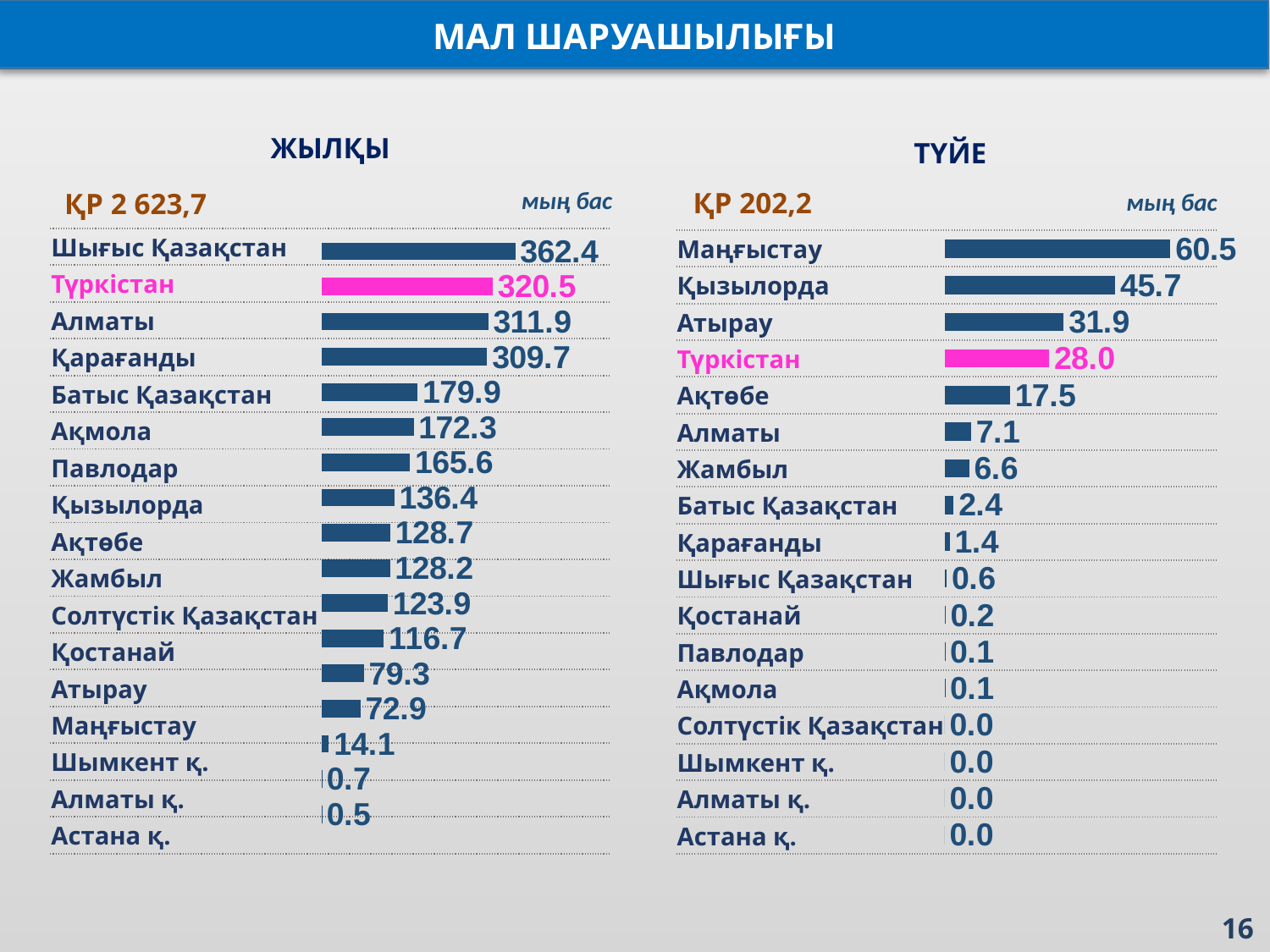
In the ЖЫЛҚЫ chart, what is the difference between Шығыс Қазақстан and Түркістан? 41.9 In the ЖЫЛҚЫ chart, what is the value for Түркістан? 320.5 In the ТҮЙЕ chart, what is the value for Маңғыстау? 60.5 In the ЖЫЛҚЫ chart, which category has the lowest value? Астана қ. What type of chart is the ТҮЙЕ chart? Bar chart How many categories are shown in the ЖЫЛҚЫ chart? 17 In the ЖЫЛҚЫ chart, which category's bar is highlighted in pink? Түркістан In the ТҮЙЕ chart, what is the difference between Қызылорда and Атырау? 13.8 In the ТҮЙЕ chart, which region has the highest value? Маңғыстау In the ЖЫЛҚЫ chart, which is larger, Батыс Қазақстан or Ақмола? Батыс Қазақстан In the ЖЫЛҚЫ chart, which region has the highest value? Шығыс Қазақстан In the ТҮЙЕ chart, what is the value for Түркістан? 28.0